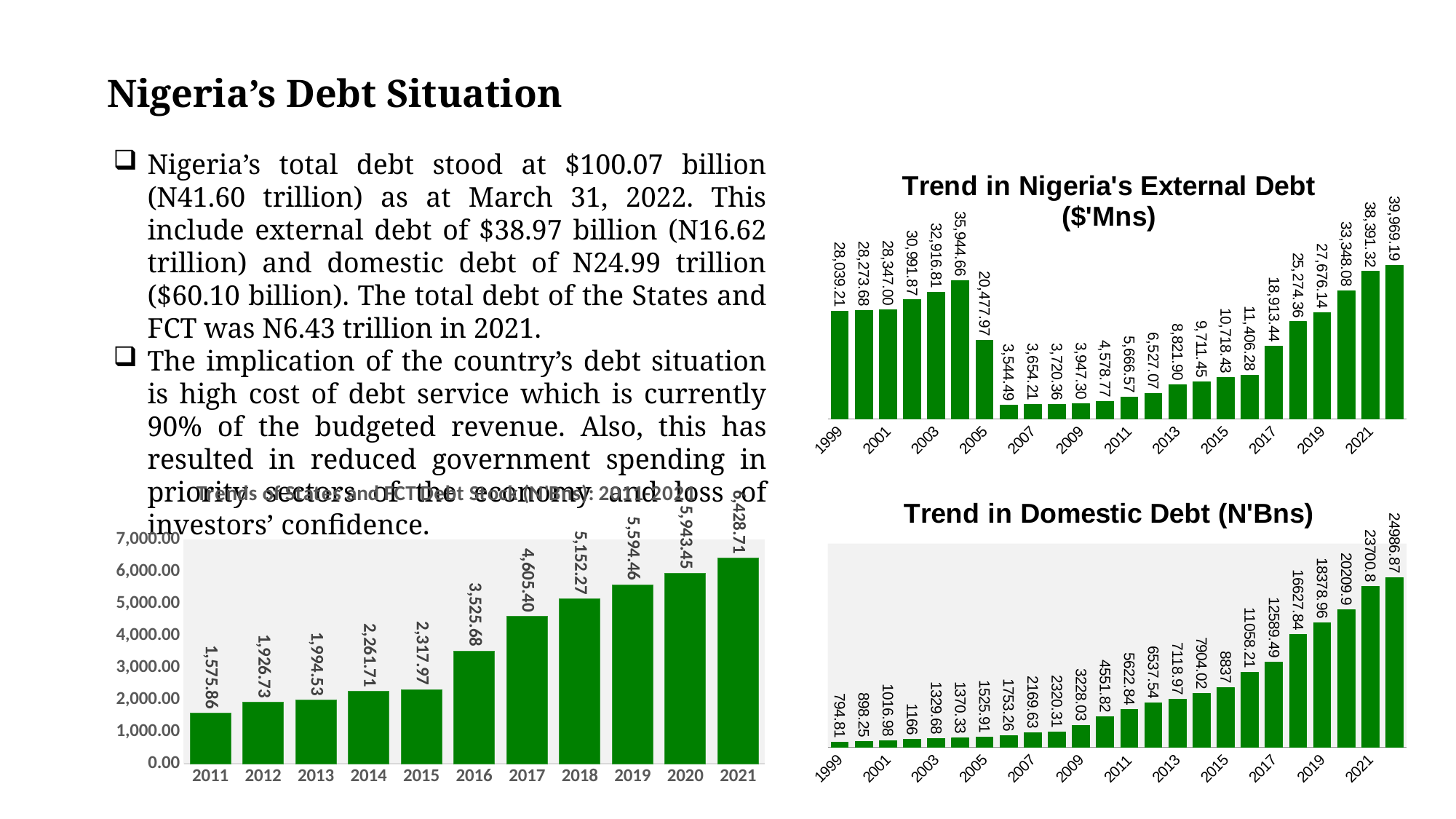
What type of chart is 'Trend in Domestic Debt (N'Bns)'? Bar chart In the 'Trend in Domestic Debt (N'Bns)' chart, what is the value for 1999? 794.81 In the bottom-left chart (States and FCT debt stock), which year has the lowest value? 2011 In the 'Trend in Nigeria's External Debt ($'Mns)' chart, what is the value for 1999? 28,039.21 In the bottom-left chart (States and FCT debt stock), what is the difference between the 2021 and 2020 values? 485.26 In the 'Trend in Nigeria's External Debt ($'Mns)' chart, which is larger: the value for 2005 or the value for 2017? 2005 In the 'Trend in Domestic Debt (N'Bns)' chart, what is the highest value shown? 24986.87 In the bottom-left chart (States and FCT debt stock), what is the value for 2021? 6,428.71 In the bottom-left chart (States and FCT debt stock), how many years are plotted? 11 In the 'Trend in Nigeria's External Debt ($'Mns)' chart, what is the value for 2021? 38,391.32 In the bottom-left chart (States and FCT debt stock), what is the value for 2016? 3,525.68